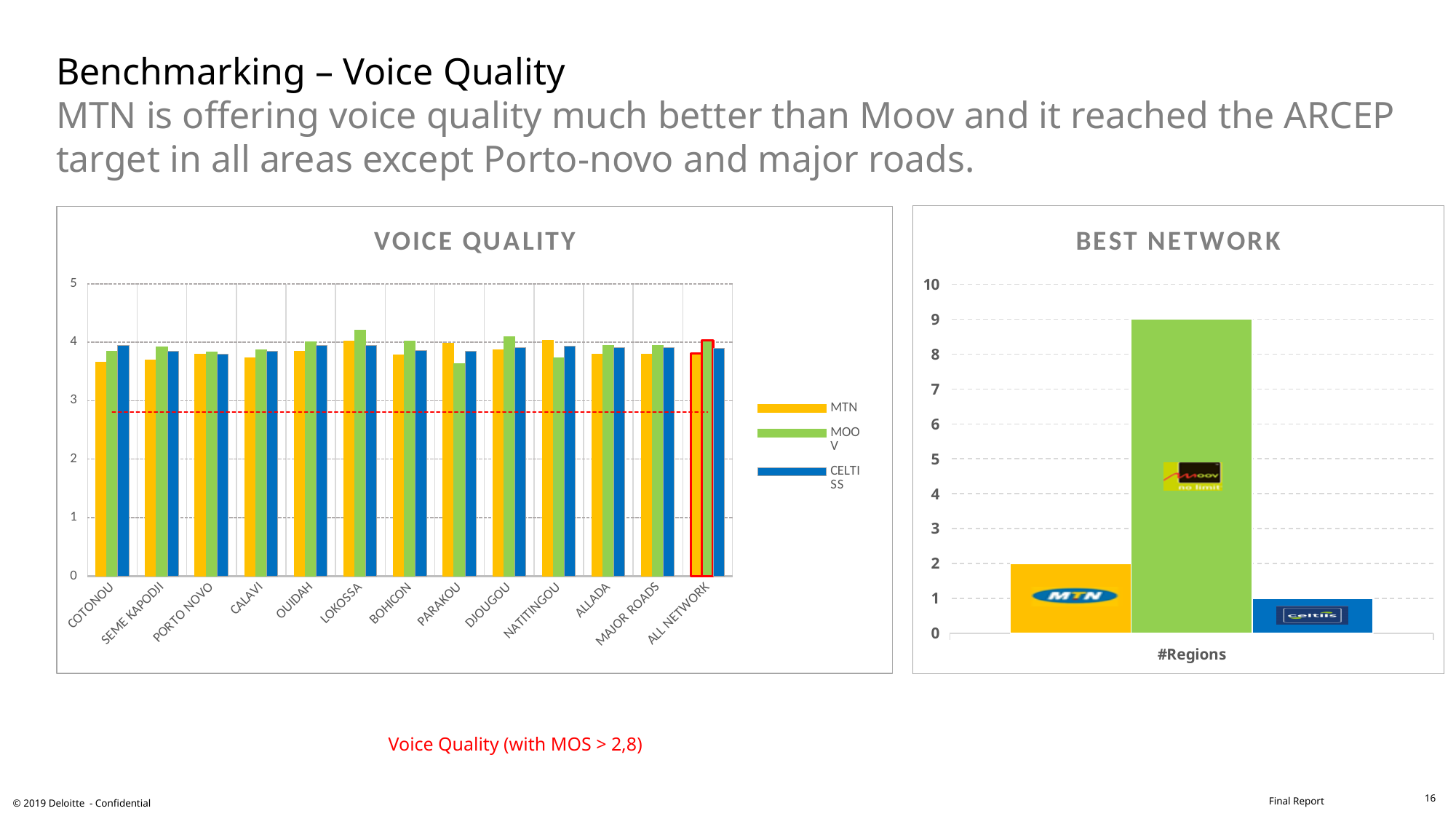
In the VOICE QUALITY chart, is the MTN value for COTONOU greater or less than 4? less In the BEST NETWORK chart, what is the difference between the Moov value and the MTN value? 7 In the BEST NETWORK chart, what is the value for Moov? 9 In the VOICE QUALITY chart, which series has the highest value for LOKOSSA? MOOV How many series does the legend of the VOICE QUALITY chart list? 3 In the VOICE QUALITY chart, which operator has the higher value for PARAKOU, MTN or MOOV? MTN How many categories are shown on the x axis of the VOICE QUALITY chart? 13 In the BEST NETWORK chart, which operator has the lowest bar? Celtiis What kind of chart is the VOICE QUALITY chart? bar chart In the BEST NETWORK chart, what is the value for MTN? 2 What is the x-axis label of the BEST NETWORK chart? #Regions In the VOICE QUALITY chart, is the MOOV value for LOKOSSA greater or less than 4? greater